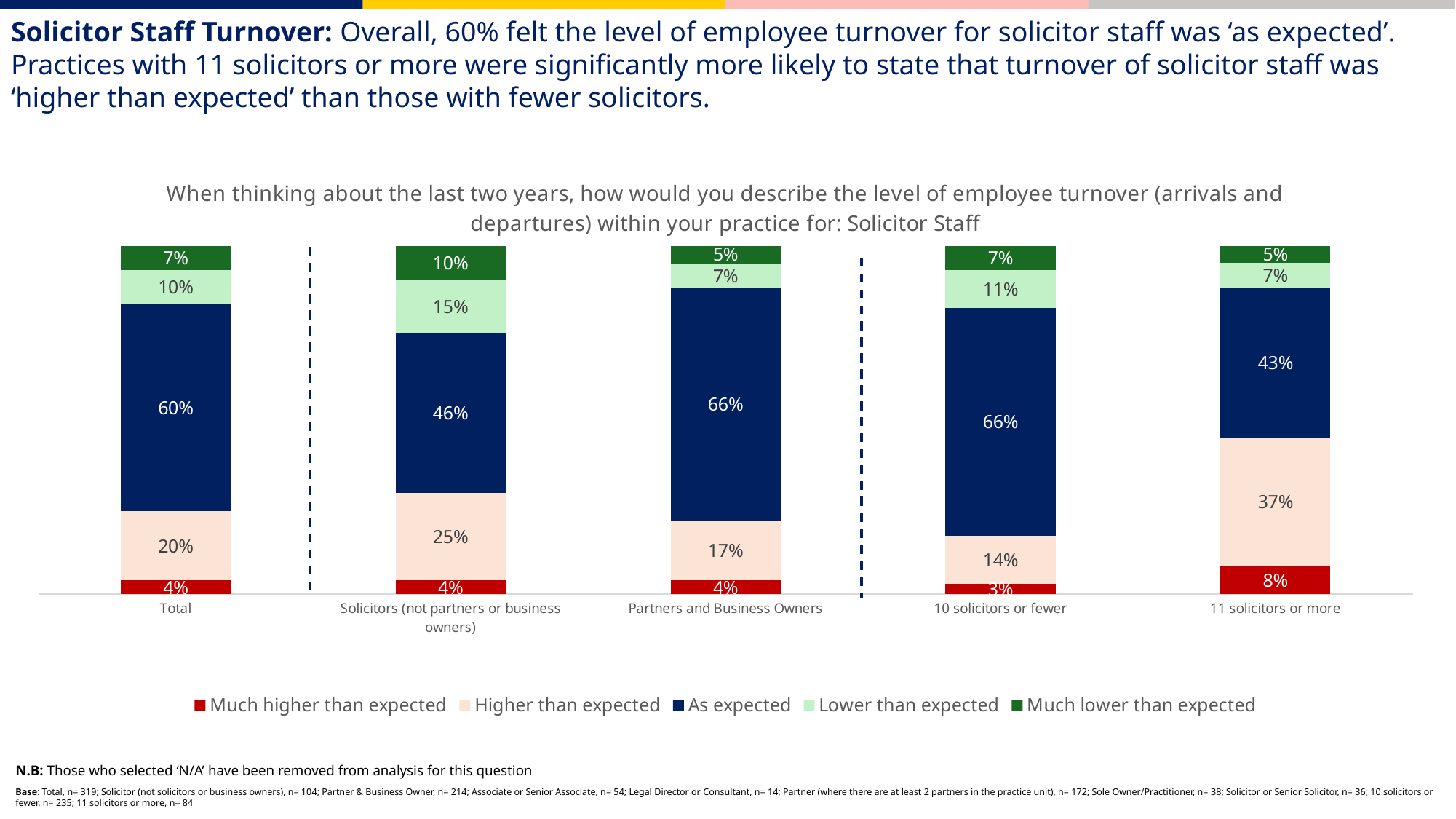
Which category has the highest 'Much lower than expected' value? Solicitors (not partners or business owners) Which has a larger 'Lower than expected' value: Solicitors (not partners or business owners) or 10 solicitors or fewer? Solicitors (not partners or business owners) What is the total of the stacked bar for 11 solicitors or more? 100% What percentage of the Total group said solicitor staff turnover was 'As expected'? 60% How many categories are shown along the x axis of the chart? 5 What percentage of practices with 10 solicitors or fewer said turnover was 'Much higher than expected'? 3% What percentage of practices with 11 solicitors or more said turnover was 'Higher than expected'? 37% Which category has the lowest 'As expected' value? 11 solicitors or more How many series does the legend list? 5 What is the difference in the 'As expected' value between Partners and Business Owners and Solicitors (not partners or business owners)? 20 percentage points What kind of chart is shown on the slide? Stacked bar chart Which category has the highest 'Higher than expected' value? 11 solicitors or more